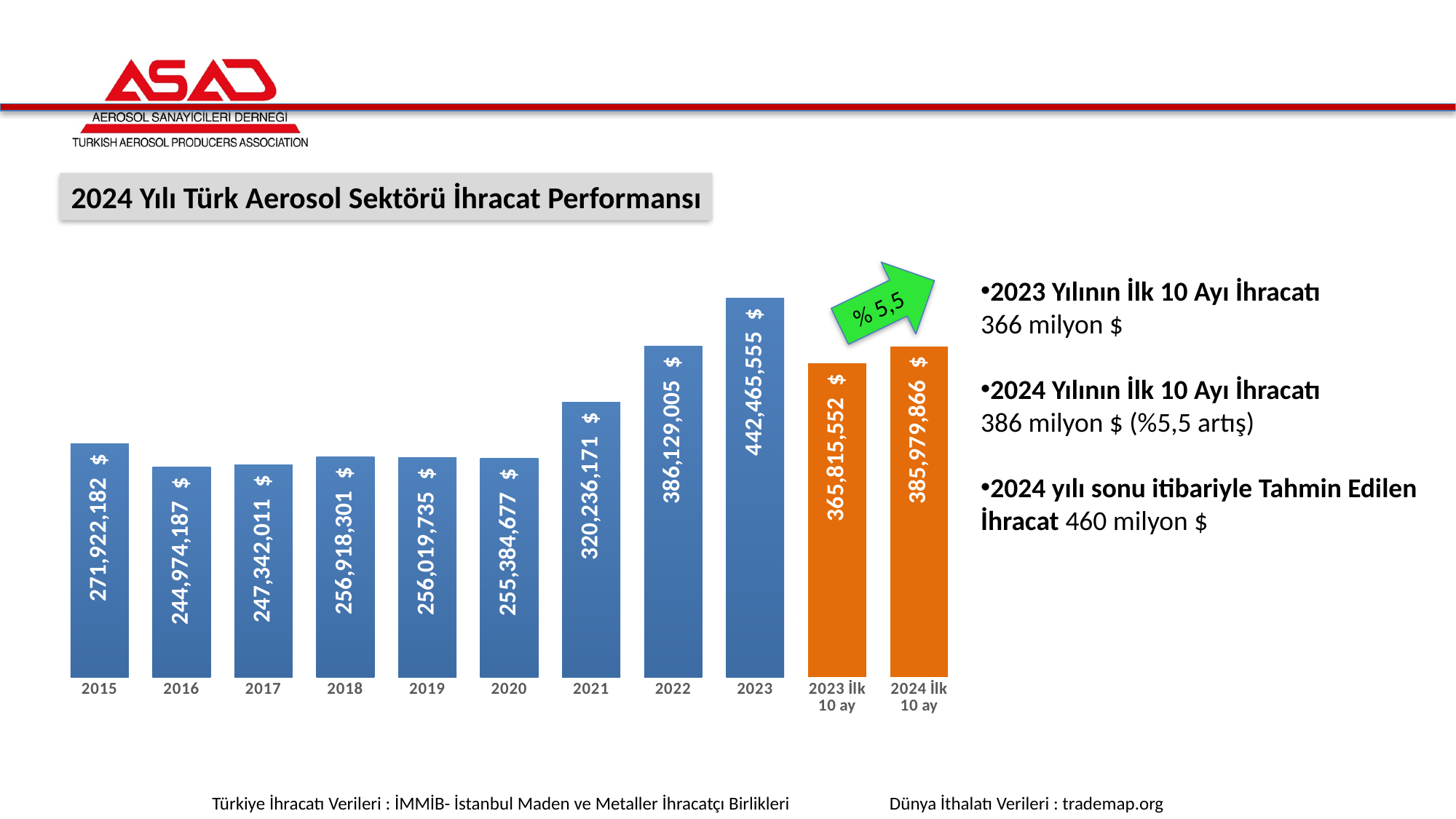
Which is larger, the value for 2021 or the value for 2020? 2021 What is the difference between the '2024 İlk 10 ay' and '2023 İlk 10 ay' values? 20,164,314 $ What is the value shown for the '2023 İlk 10 ay' bar? 365,815,552 $ What is the export value shown for 2016? 244,974,187 $ What is the difference between the 2023 and 2022 values? 56,336,550 $ Do the values rise or fall from 2020 to 2023? Rise How many bars are shown in the chart? 11 Which bar has the lowest value? 2016 What is the export value shown for 2023? 442,465,555 $ What is the value shown for the '2024 İlk 10 ay' bar? 385,979,866 $ What kind of chart is shown on the slide? Bar chart Which bar has the highest value? 2023